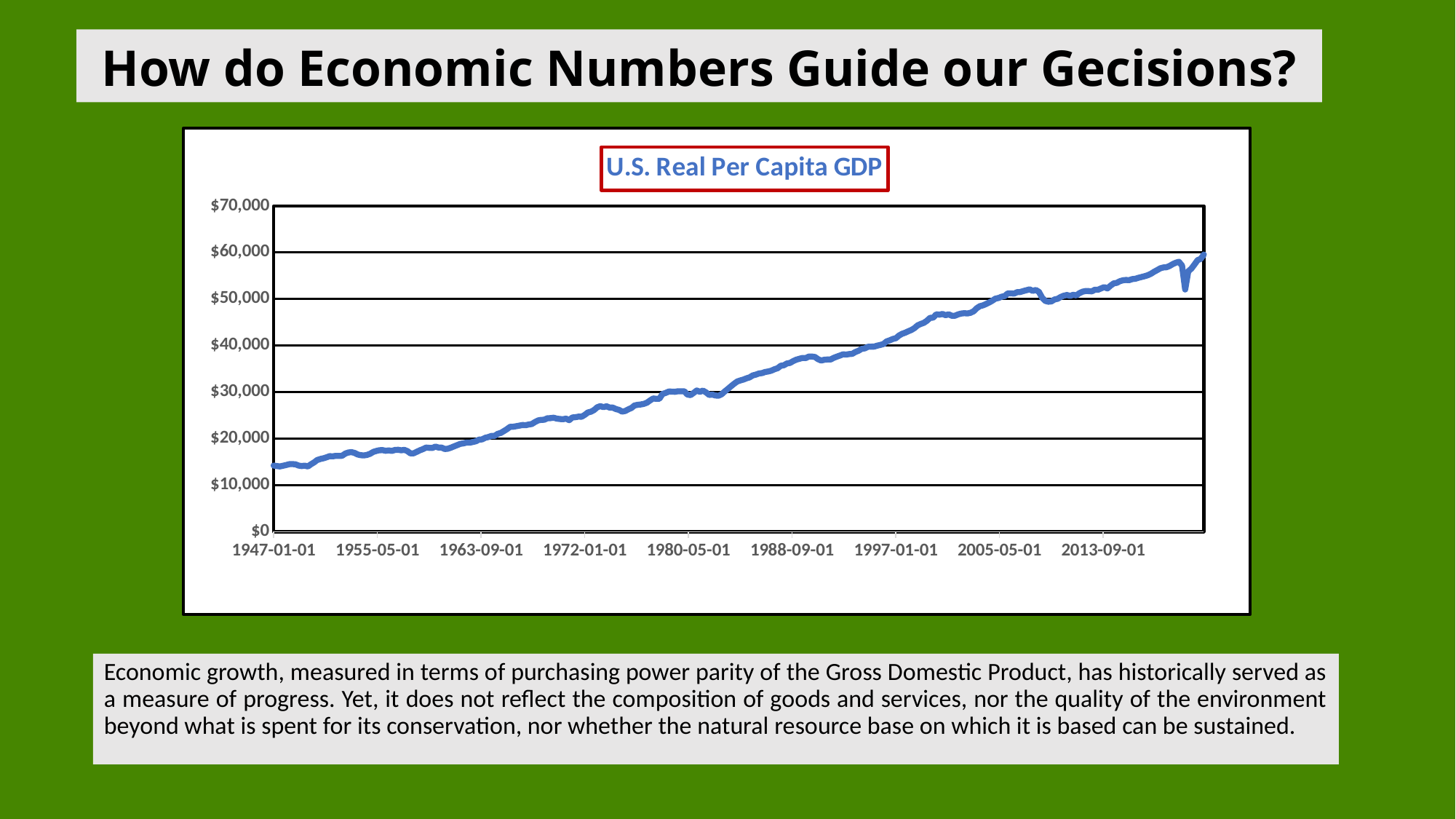
Is the value at 2013-09-01 greater or less than $40,000? greater What is the first date label on the x axis? 1947-01-01 What kind of chart is shown on the slide? line chart Is the value at 1980-05-01 greater or less than $20,000? greater How many date labels are shown on the x axis? 9 What is the highest value shown on the y axis? $70,000 Which is larger, the value at 1947-01-01 or the value at 2013-09-01? 2013-09-01 Do the values in the chart generally rise or fall from left to right along the x axis? rise Is the value at 1997-01-01 greater or less than $50,000? less What is the title of the chart? U.S. Real Per Capita GDP